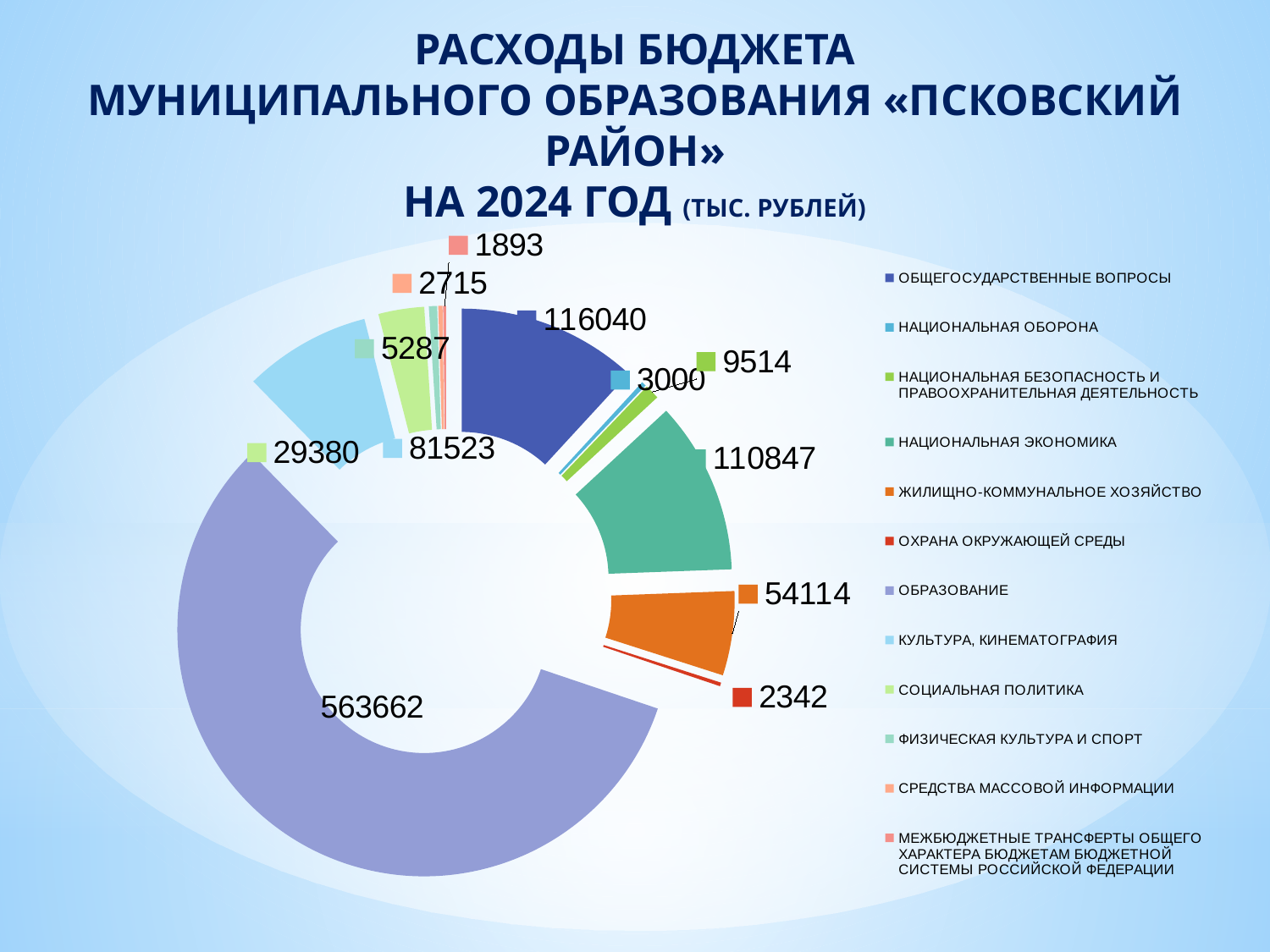
What is the value for КУЛЬТУРА, КИНЕМАТОГРАФИЯ? 81523 How many categories does the legend list? 12 What unit is stated in the chart title? ТЫС. РУБЛЕЙ What kind of chart is shown on the slide? Doughnut (pie) chart What is the value for ОБЩЕГОСУДАРСТВЕННЫЕ ВОПРОСЫ? 116040 Which category has the highest value? ОБРАЗОВАНИЕ What is the value for ЖИЛИЩНО-КОММУНАЛЬНОЕ ХОЗЯЙСТВО? 54114 Which category has the lowest value? МЕЖБЮДЖЕТНЫЕ ТРАНСФЕРТЫ ОБЩЕГО ХАРАКТЕРА БЮДЖЕТАМ БЮДЖЕТНОЙ СИСТЕМЫ РОССИЙСКОЙ ФЕДЕРАЦИИ What is the value for ОХРАНА ОКРУЖАЮЩЕЙ СРЕДЫ? 2342 Which is larger: the value for СОЦИАЛЬНАЯ ПОЛИТИКА or the value for НАЦИОНАЛЬНАЯ БЕЗОПАСНОСТЬ И ПРАВООХРАНИТЕЛЬНАЯ ДЕЯТЕЛЬНОСТЬ? СОЦИАЛЬНАЯ ПОЛИТИКА What is the value for ОБРАЗОВАНИЕ? 563662 What is the difference between the values for ОБЩЕГОСУДАРСТВЕННЫЕ ВОПРОСЫ and НАЦИОНАЛЬНАЯ ЭКОНОМИКА? 5193